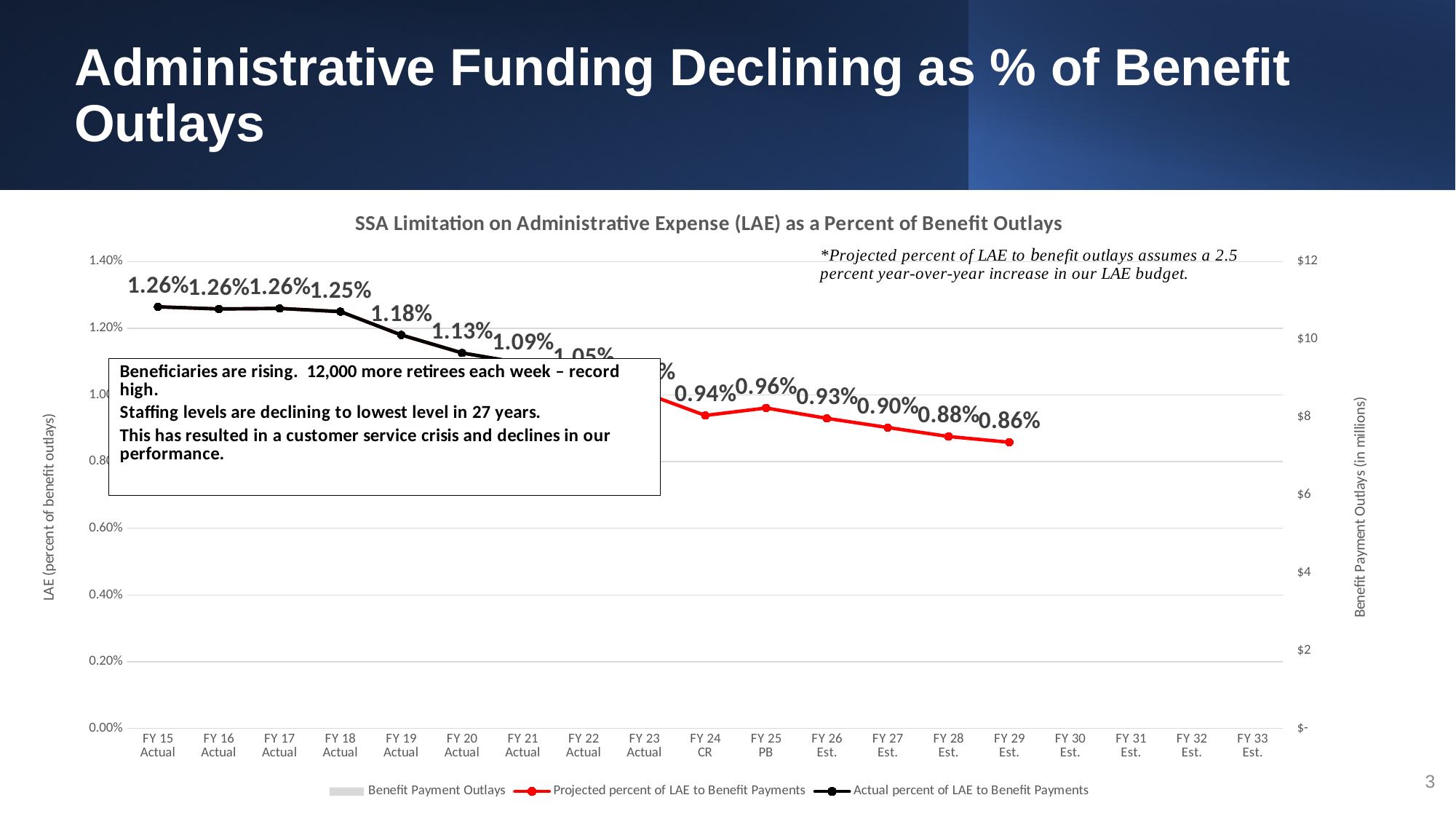
What is the projected percent of LAE to benefit payments for FY 29 Est.? 0.86% What kind of chart is shown on the slide? line chart How many series does the chart legend list? 3 Which is larger, the projected percent for FY 25 PB or for FY 26 Est.? FY 25 PB What is the difference between the FY 18 Actual value (1.25%) and the FY 19 Actual value (1.18%)? 0.07 percentage points What is the projected percent of LAE to benefit payments for FY 24 CR? 0.94% What is the actual percent of LAE to benefit payments for FY 20 Actual? 1.13% How many fiscal year categories are shown on the x axis? 19 What is the actual percent of LAE to benefit payments for FY 19 Actual? 1.18% Do the percent of LAE to benefit payments values generally rise or fall from FY 15 to FY 29? fall What is the label on the right-hand vertical axis? Benefit Payment Outlays (in millions) Which fiscal year has the lowest labeled percent of LAE to benefit payments? FY 29 Est.